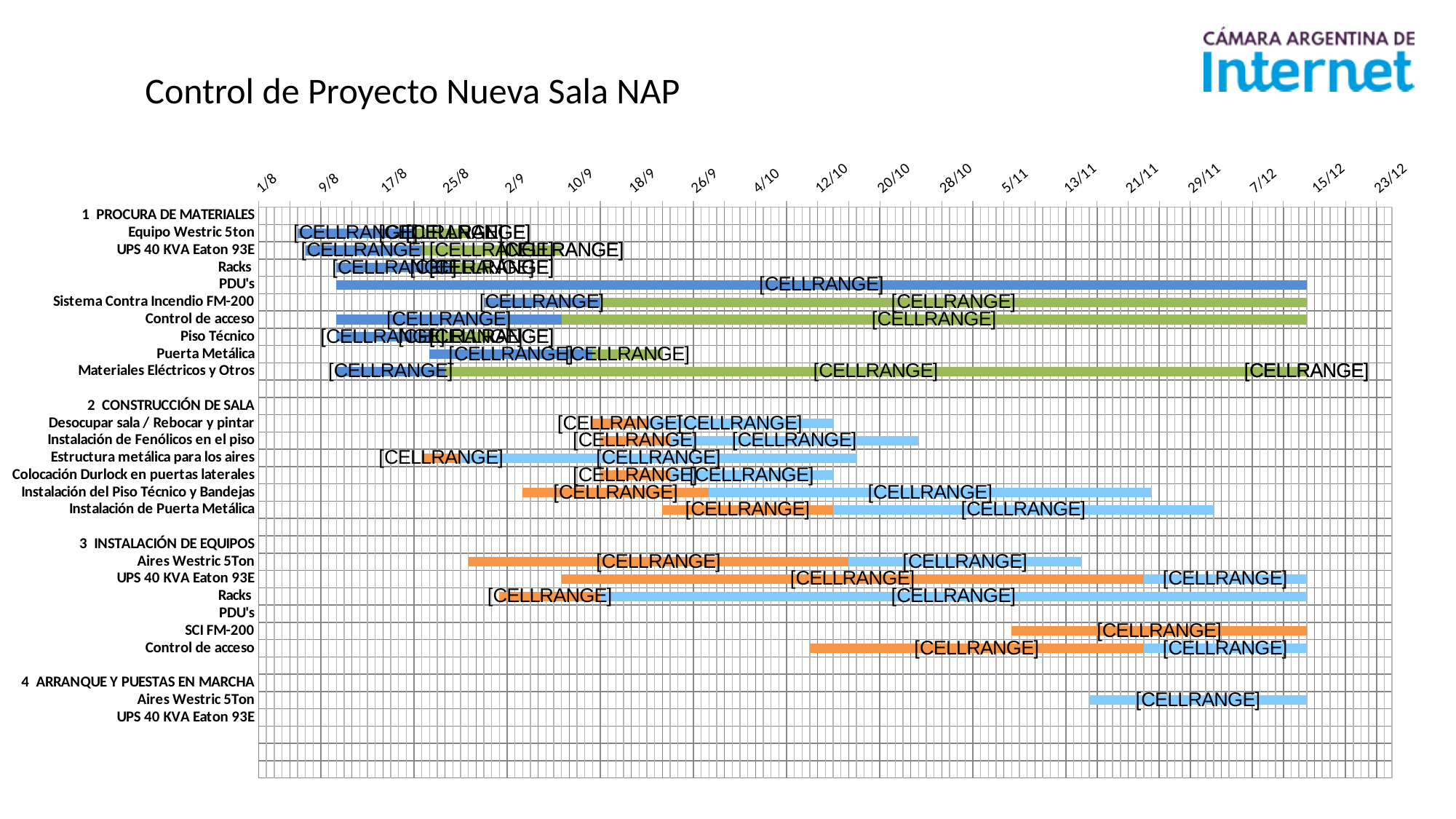
How many tasks are listed under phase 2, CONSTRUCCIÓN DE SALA? 6 What is the title of the slide's chart? Control de Proyecto Nueva Sala NAP Does the bar for Aires Westric 5Ton under phase 4 begin before or after 13/11? after What is the last date shown on the chart's time axis? 23/12 What kind of chart is shown on the slide? bar chart (Gantt chart) What is the first date shown on the chart's time axis? 1/8 Which task under phase 3, INSTALACIÓN DE EQUIPOS, has no bar plotted? PDU's Which task under phase 2, CONSTRUCCIÓN DE SALA, starts earliest? Estructura metálica para los aires Which task under phase 4, ARRANQUE Y PUESTAS EN MARCHA, has a bar plotted? Aires Westric 5Ton How many tasks are listed under phase 1, PROCURA DE MATERIALES? 9 Which task under phase 3, INSTALACIÓN DE EQUIPOS, starts latest? SCI FM-200 How many numbered project phases are listed on the chart? 4